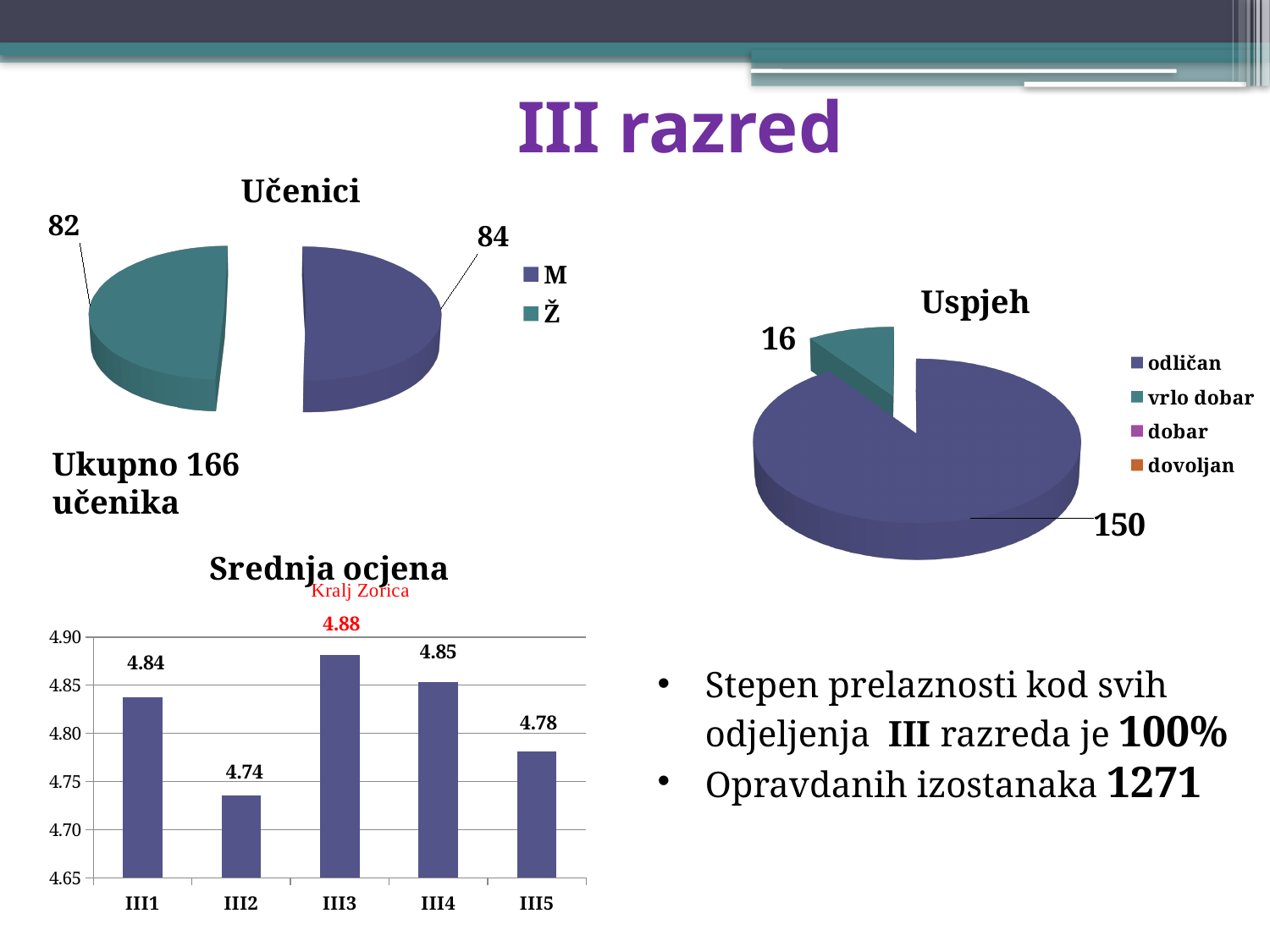
In the "Srednja ocjena" chart, which category has the lowest value? III2 In the "Srednja ocjena" chart, what is the difference between the values for III3 and III2? 0.14 In the "Srednja ocjena" chart, how many categories are shown on the x axis? 5 In the "Uspjeh" pie chart, how many entries does the legend list? 4 In the "Uspjeh" pie chart, what is the value for odličan? 150 In the "Učenici" pie chart, what is the difference between the M and Ž values? 2 In the "Srednja ocjena" chart, what is the value for III3? 4.88 In the "Uspjeh" pie chart, what is the value for vrlo dobar? 16 In the "Učenici" pie chart, what is the value for Ž? 82 What kind of chart is the "Srednja ocjena" chart? bar chart In the "Učenici" pie chart, what is the value for M? 84 In the "Srednja ocjena" chart, which category has the highest value? III3